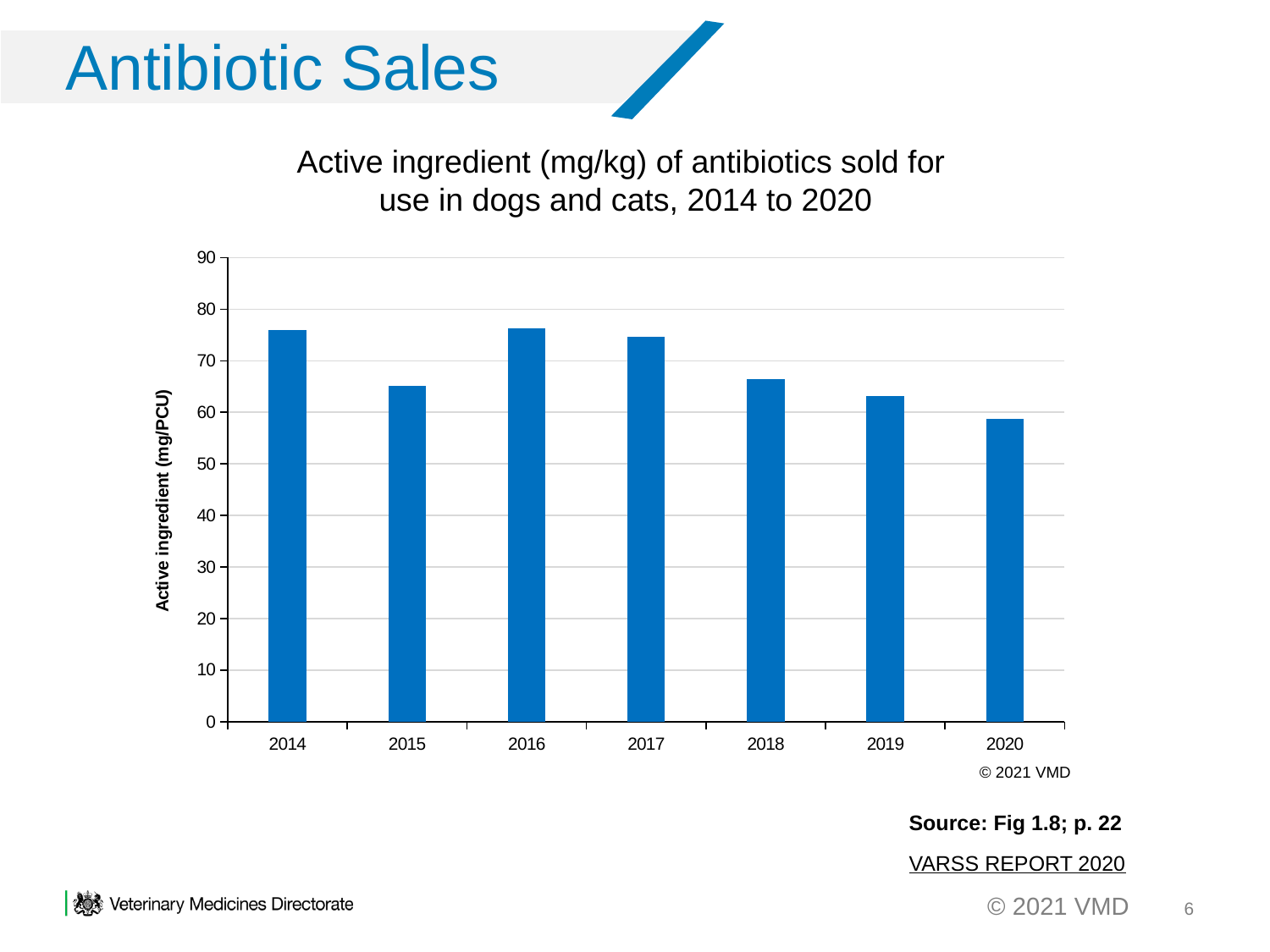
Is the value for 2018 greater or less than 70? less Which year has the larger value, 2017 or 2020? 2017 Is the value for 2020 greater or less than 60? less What is the label on the y axis of the chart? Active ingredient (mg/PCU) Which year has the lowest value for active ingredient sold? 2020 Is the value for 2019 greater or less than 60? greater How many years are plotted on the x axis? 7 Overall, do the values rise or fall from 2016 to 2020? fall Which year has the larger value, 2014 or 2015? 2014 What kind of chart is shown on the slide? bar chart